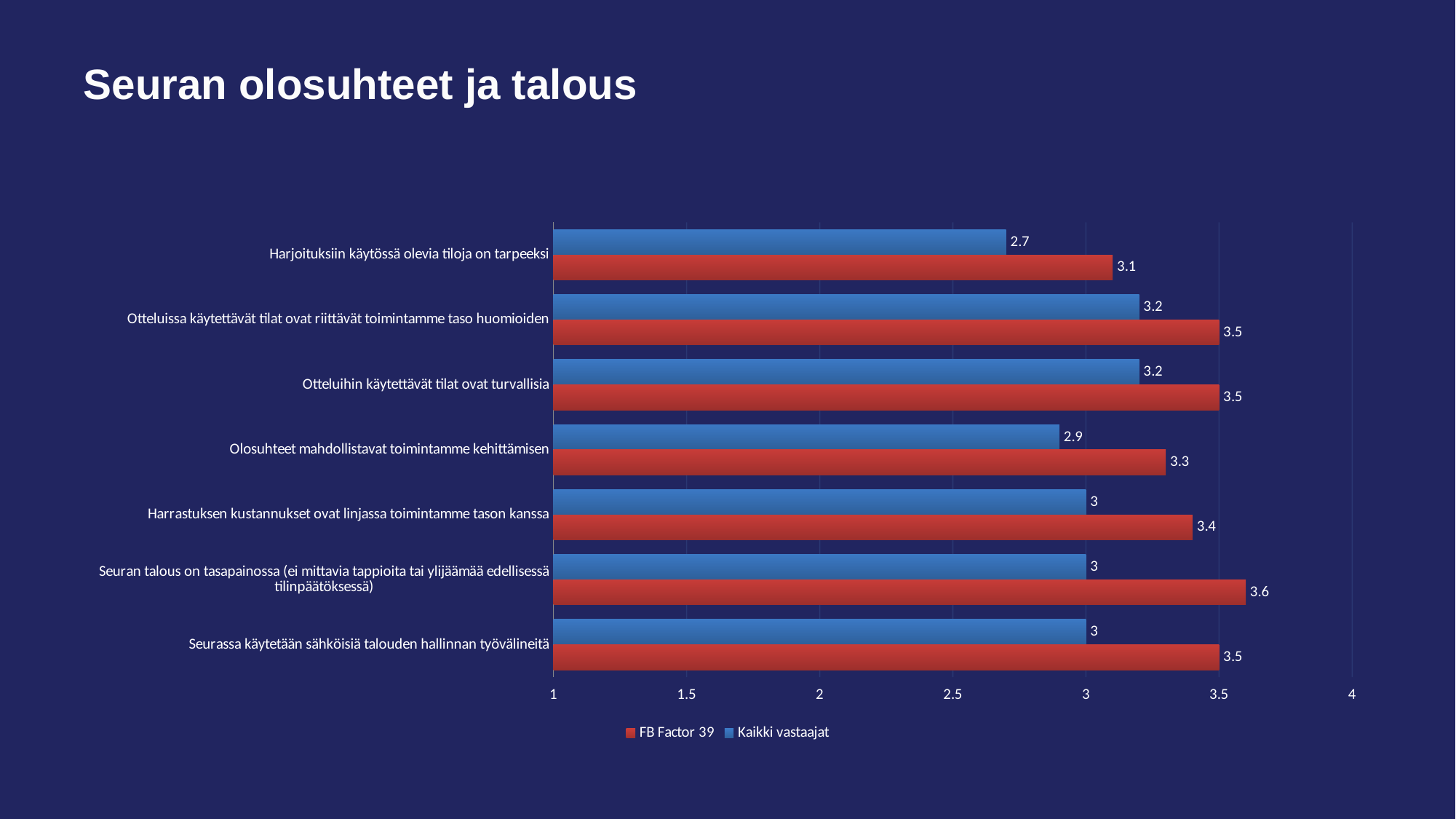
How many categories are shown in the chart? 7 Is the Kaikki vastaajat value for "Harjoituksiin käytössä olevia tiloja on tarpeeksi" greater or less than 3? less Which category has the highest FB Factor 39 value? Seuran talous on tasapainossa (ei mittavia tappioita tai ylijäämää edellisessä tilinpäätöksessä) What is the title of the slide? Seuran olosuhteet ja talous What is the difference between the FB Factor 39 and Kaikki vastaajat values for "Seuran talous on tasapainossa (ei mittavia tappioita tai ylijäämää edellisessä tilinpäätöksessä)"? 0.6 What kind of chart is shown on the slide? Bar chart Which category has the lowest Kaikki vastaajat value? Harjoituksiin käytössä olevia tiloja on tarpeeksi How many series does the legend list? 2 What is the Kaikki vastaajat value for "Olosuhteet mahdollistavat toimintamme kehittämisen"? 2.9 What is the FB Factor 39 value for "Seuran talous on tasapainossa (ei mittavia tappioita tai ylijäämää edellisessä tilinpäätöksessä)"? 3.6 What is the FB Factor 39 value for "Harjoituksiin käytössä olevia tiloja on tarpeeksi"? 3.1 For "Harrastuksen kustannukset ovat linjassa toimintamme tason kanssa", which series has the larger value, FB Factor 39 or Kaikki vastaajat? FB Factor 39